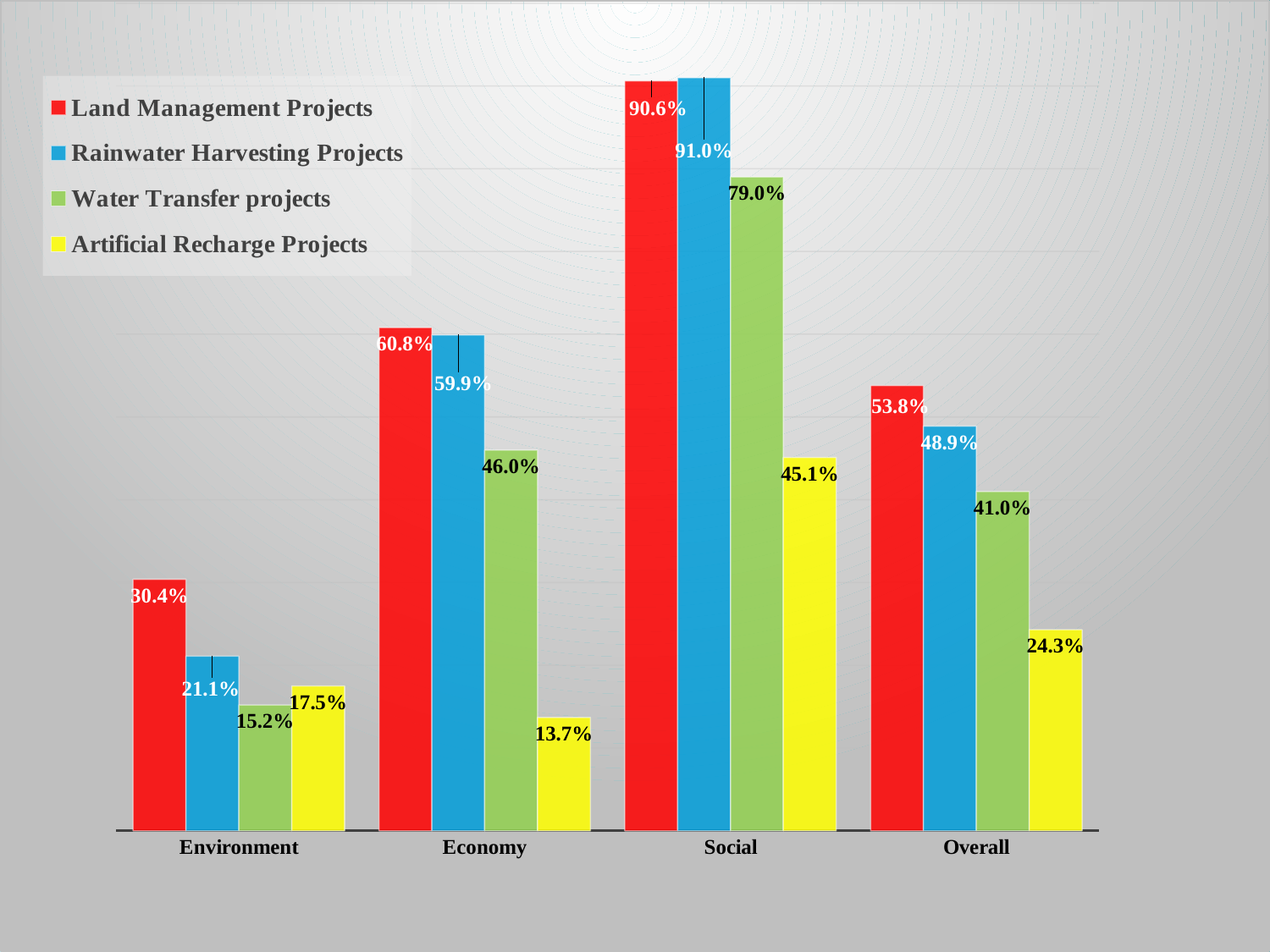
What is the value for Land Management Projects in the Environment category? 30.4% Which colour represents Water Transfer projects in the legend? Green What is the value for Rainwater Harvesting Projects in the Overall category? 48.9% Which category has the lowest value for Artificial Recharge Projects? Economy In the Environment category, which is larger: Water Transfer projects or Artificial Recharge Projects? Artificial Recharge Projects What kind of chart is shown on the slide? Bar chart What is the difference between Land Management Projects and Artificial Recharge Projects in the Overall category? 29.5% What is the value for Artificial Recharge Projects in the Economy category? 13.7% How many series does the legend list? 4 What is the value for Water Transfer projects in the Social category? 79.0% How many categories are shown on the x axis? 4 Which category has the highest value for Land Management Projects? Social